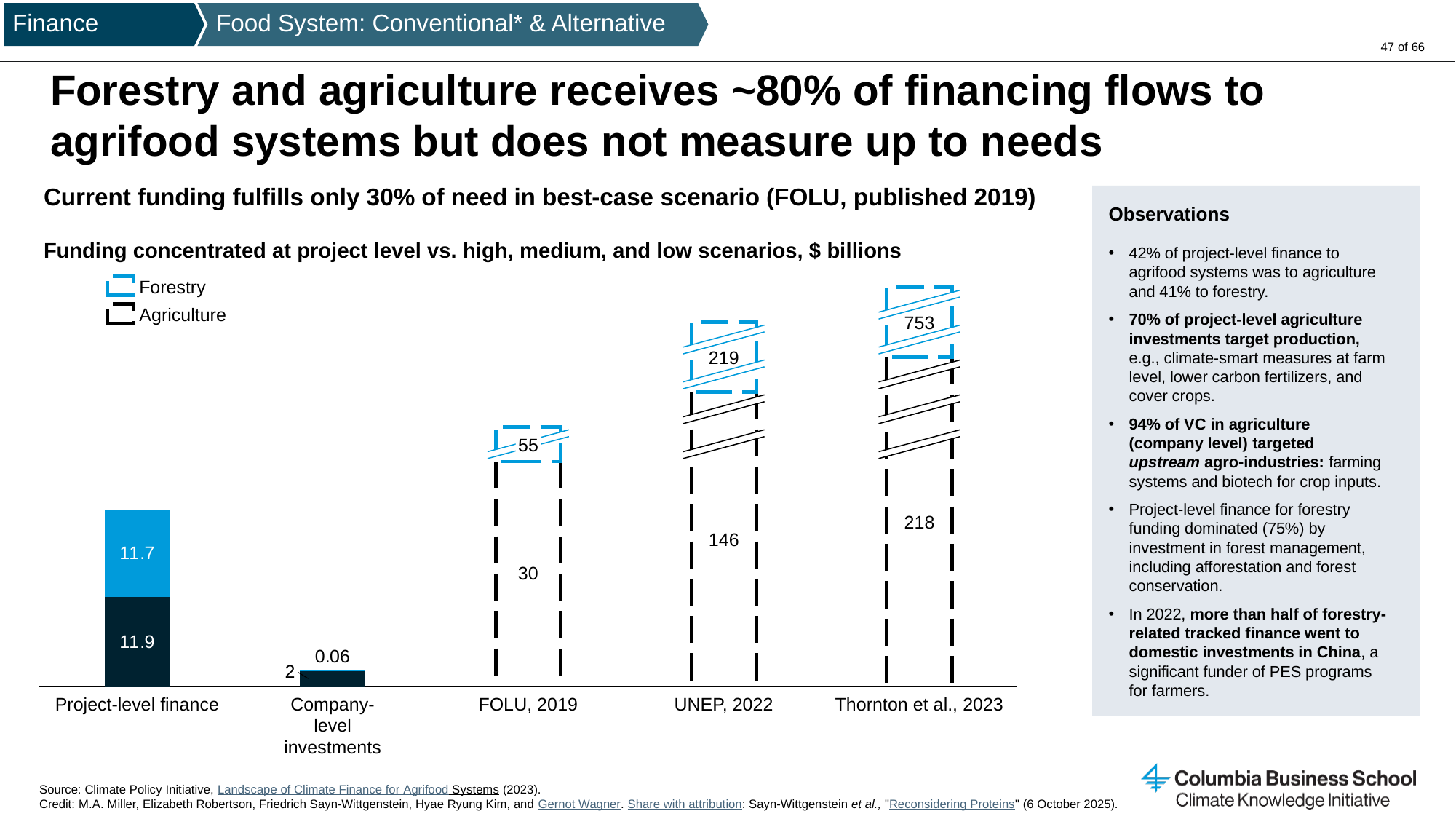
What is the Forestry value for Company-level investments? 0.06 How many series does the legend list? 2 What is the total of the Forestry and Agriculture values for Thornton et al., 2023? 971 What is the Forestry value for Thornton et al., 2023? 753 What is the difference between the Forestry and Agriculture values for FOLU, 2019? 25 Which category has the lowest Agriculture value? Company-level investments What is the Agriculture value for UNEP, 2022? 146 Which category has the highest Forestry value? Thornton et al., 2023 Which is larger for UNEP, 2022: the Forestry value or the Agriculture value? Forestry What is the Forestry value for Project-level finance? 11.7 What is the Agriculture value for Project-level finance? 11.9 How many categories are shown on the x axis? 5